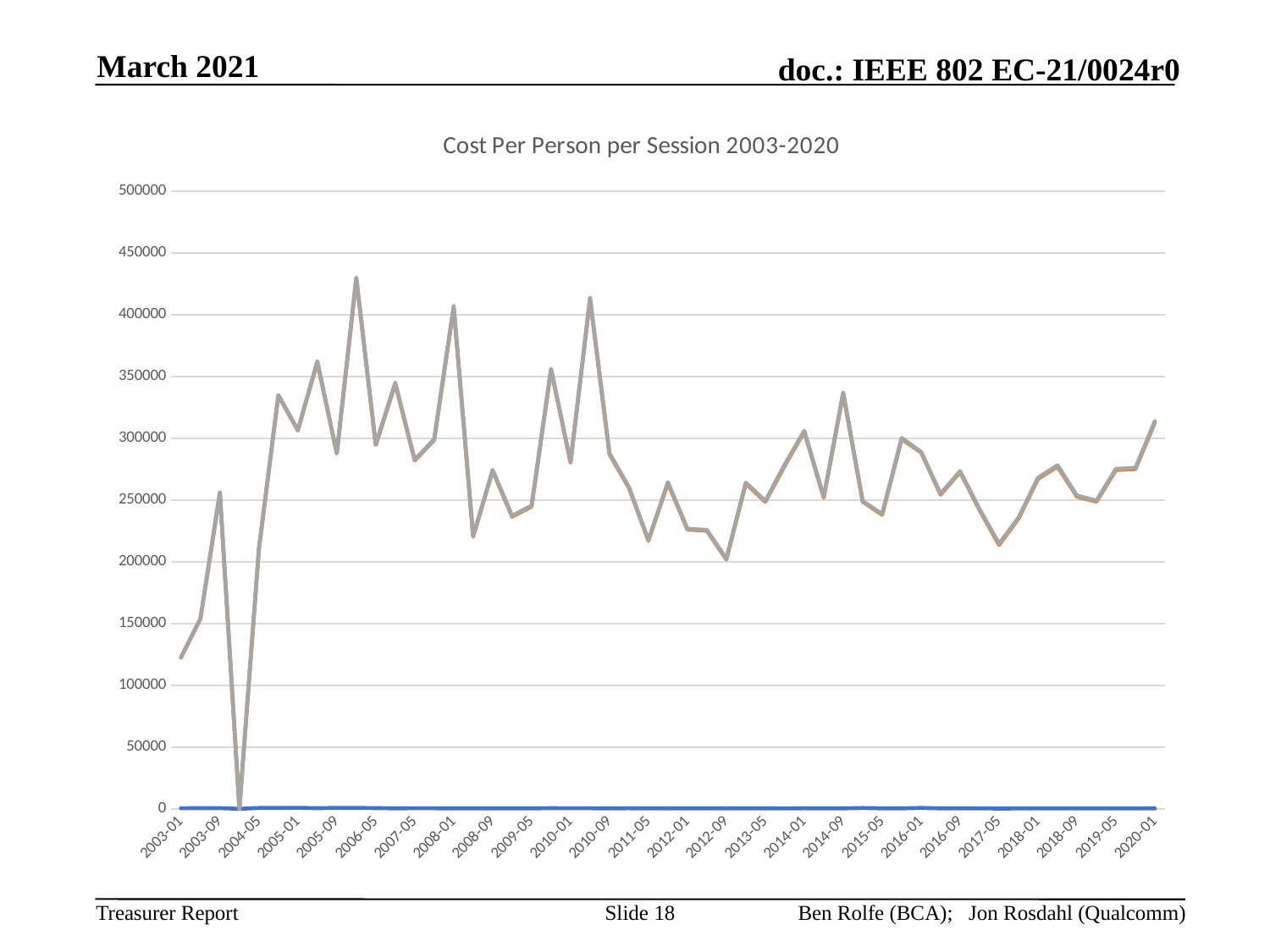
Is the value for 2003-01 greater or less than 150000? less Which is larger, the value for 2006-05 or the value for 2003-01? 2006-05 What kind of chart is shown on the slide? line chart Is the value for 2008-01 greater or less than 350000? greater Which labelled session has the highest cost per person? 2008-01 What is the title of the chart? Cost Per Person per Session 2003-2020 Is the value for 2006-05 greater or less than 400000? less Does the value rise or fall from 2010-09 to 2012-09? fall What is the highest value shown on the vertical axis? 500000